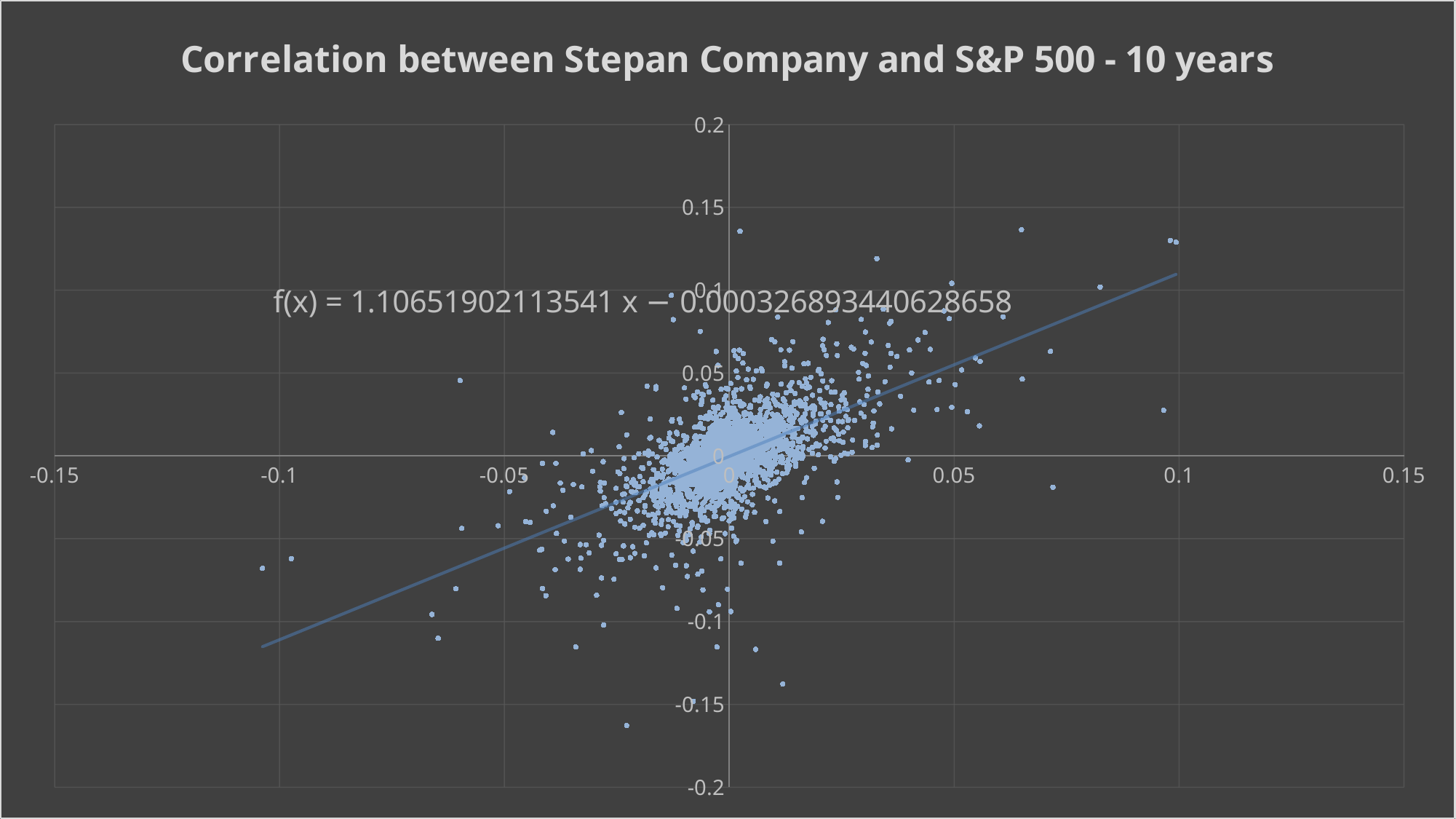
Does the trendline rise or fall as the x values increase? Rise What is the intercept term in the trendline equation printed on the chart? -0.000326893440628658 What kind of chart is shown on the slide? Scatter plot What is the title of the chart? Correlation between Stepan Company and S&P 500 - 10 years What is the slope of the trendline equation printed on the chart? 1.10651902113541 Is the correlation between the two variables shown as positive or negative? Positive What is the highest value shown on the y axis? 0.2